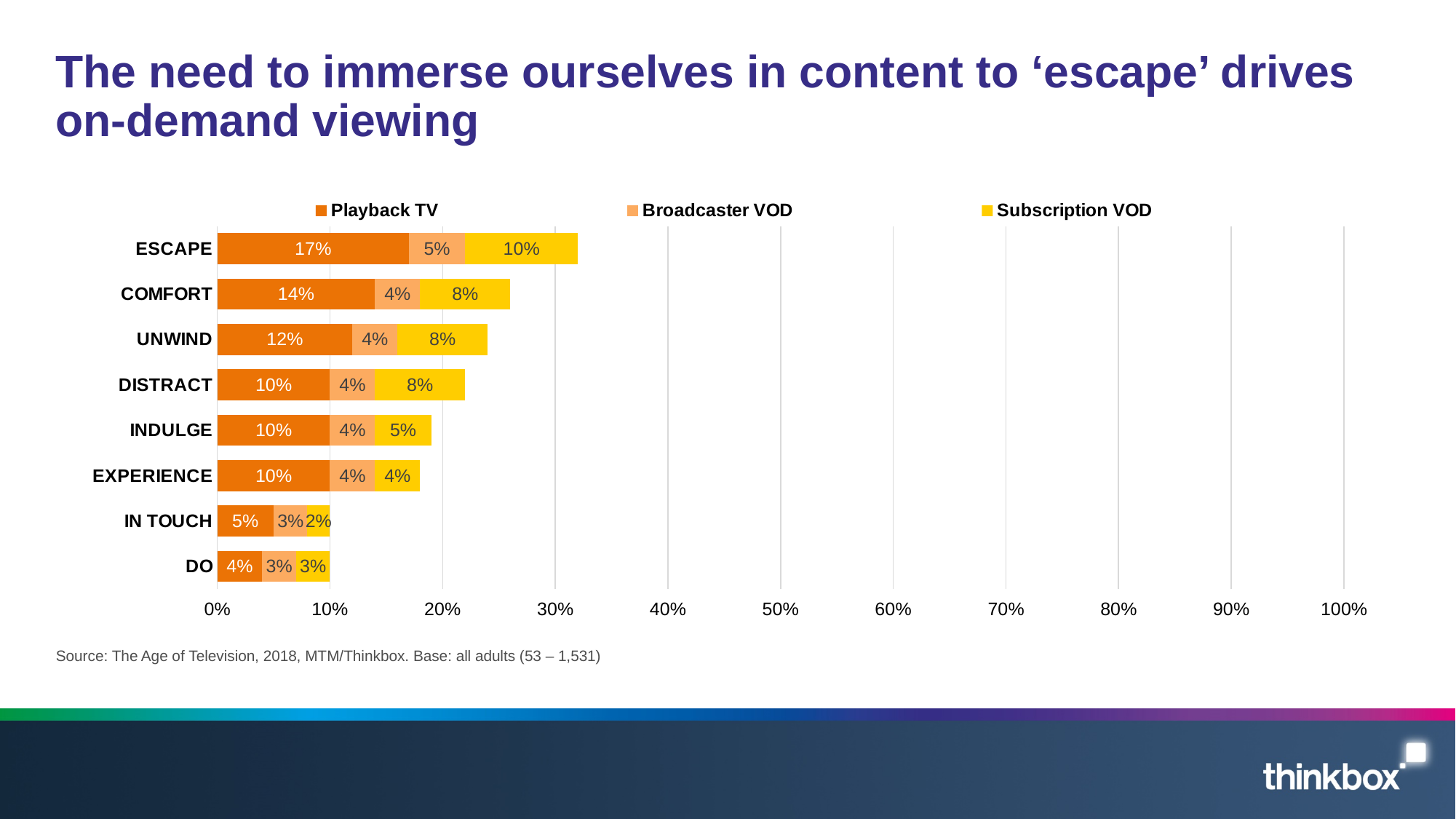
What kind of chart is shown on the slide? Stacked bar chart What is the Playback TV value for ESCAPE? 17% Which category has the lowest Subscription VOD value? IN TOUCH What is the Subscription VOD value for COMFORT? 8% What is the total of the stacked bar for UNWIND? 24% What is the total of the stacked bar for ESCAPE? 32% Which is larger: the Subscription VOD value for INDULGE or for EXPERIENCE? INDULGE Which category has the highest Playback TV value? ESCAPE What is the difference between the Playback TV values for ESCAPE and COMFORT? 3% How many series does the legend list? 3 How many categories are shown on the chart? 8 What is the Broadcaster VOD value for IN TOUCH? 3%